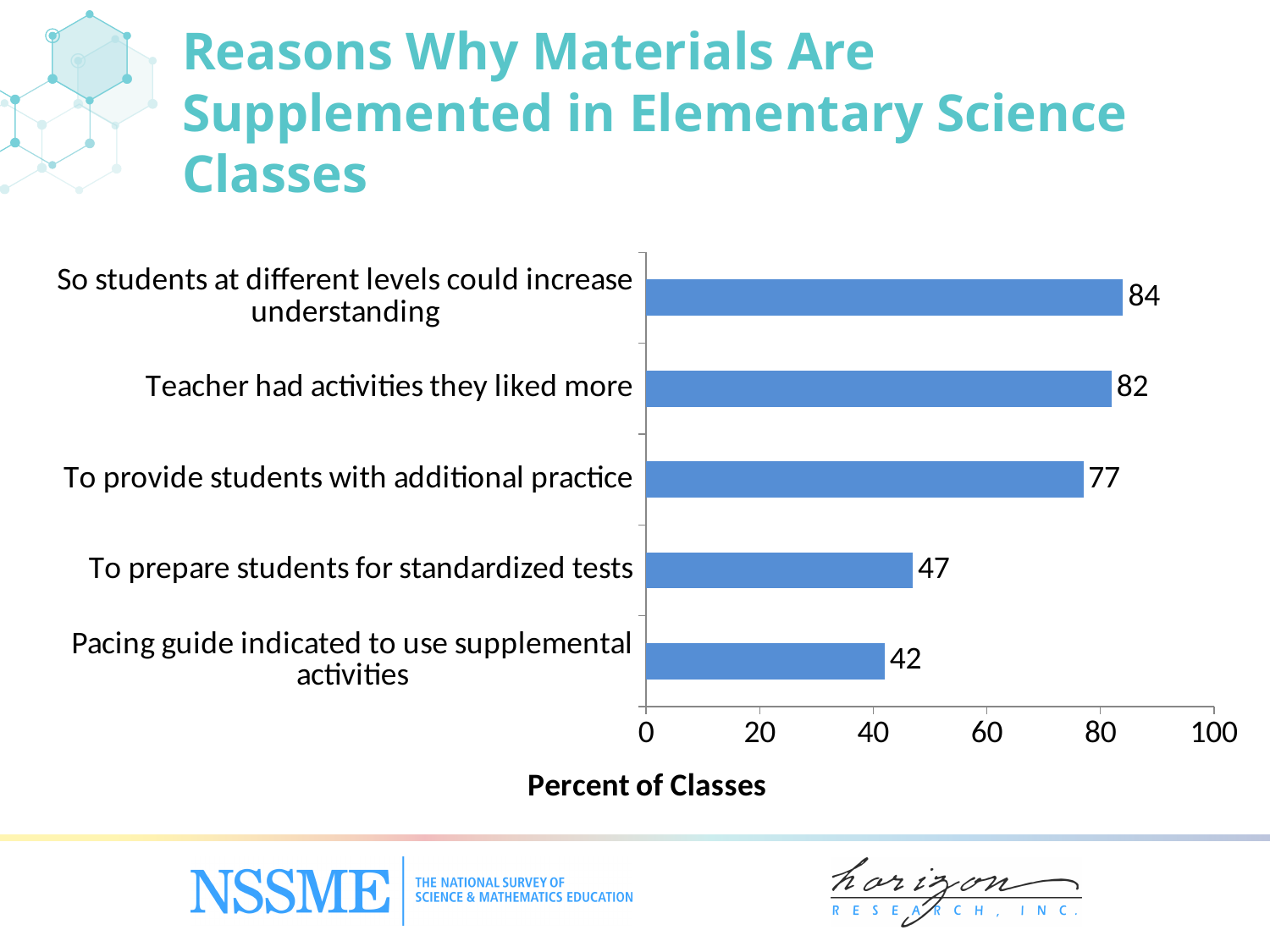
Which is larger: the value for 'To prepare students for standardized tests' or for 'Pacing guide indicated to use supplemental activities'? To prepare students for standardized tests How many reasons are shown in the chart? 5 What is the difference between the values for 'To provide students with additional practice' and 'To prepare students for standardized tests'? 30 What is the value for 'Teacher had activities they liked more'? 82 What kind of chart is shown on the slide? Bar chart What percent of classes supplemented materials to provide students with additional practice? 77 Which reason has the lowest percent of classes? Pacing guide indicated to use supplemental activities What is the label of the horizontal axis? Percent of Classes What percent of classes supplemented materials so students at different levels could increase understanding? 84 Which reason has the highest percent of classes? So students at different levels could increase understanding What is the value for 'To prepare students for standardized tests'? 47 What percent of classes supplemented materials because the pacing guide indicated to use supplemental activities? 42